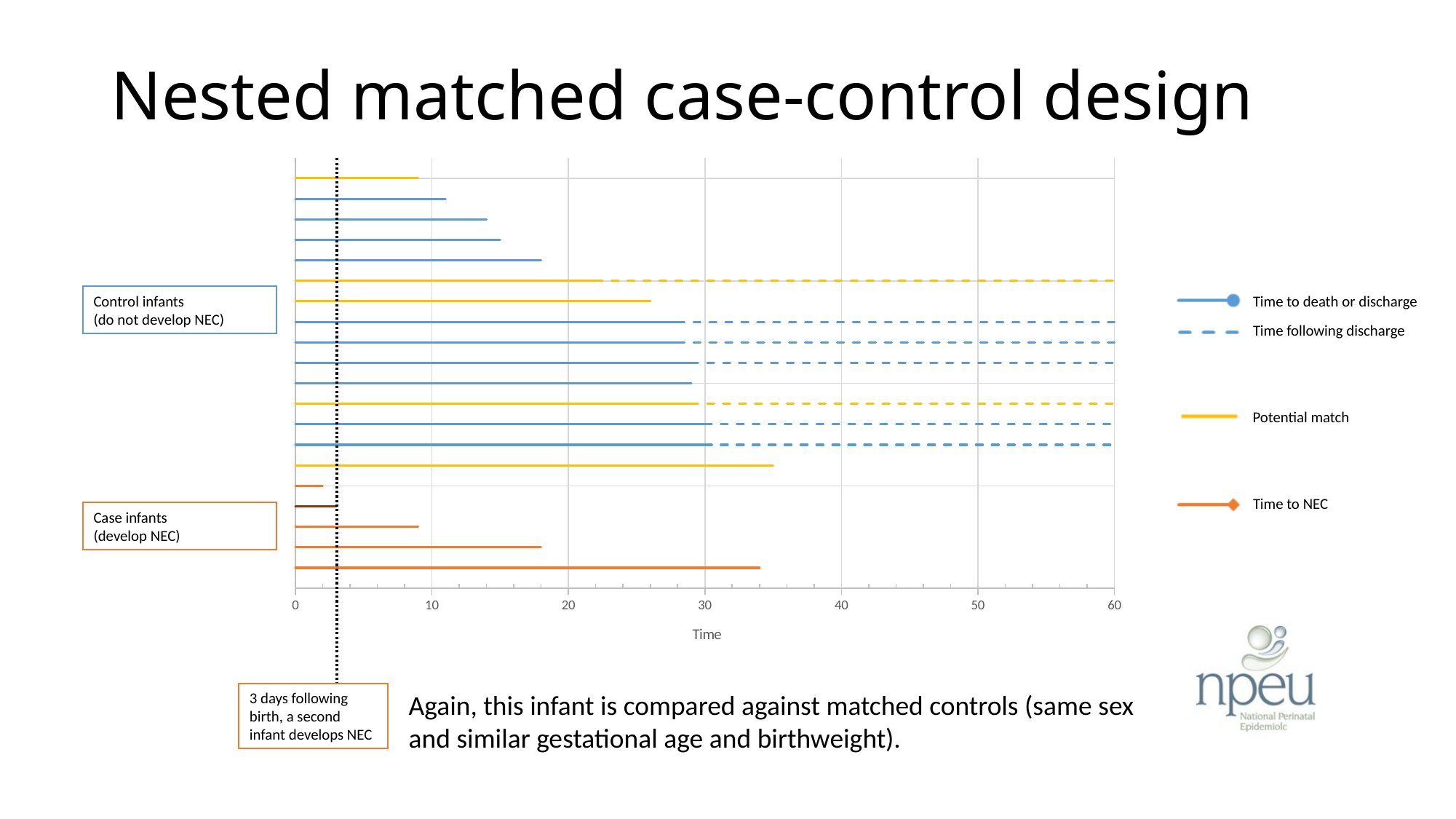
Up to what value on the Time axis do the dashed 'Time following discharge' lines extend? 60 What is the title of the x axis on the chart? Time What is the highest value shown on the x axis of the chart? 60 Is the longest solid 'Potential match' line greater or less than 30 on the Time axis? greater Which group of infants is plotted in the lower rows of the chart, control infants or case infants? Case infants Which legend entry is drawn with a dashed line? Time following discharge Is the shortest 'Time to NEC' line for the case infants greater or less than 10 on the Time axis? less Is the shortest solid 'Time to death or discharge' line greater or less than 20 on the Time axis? less How many entries does the chart's legend list? 4 At what value on the Time axis is the vertical dotted line drawn? 3